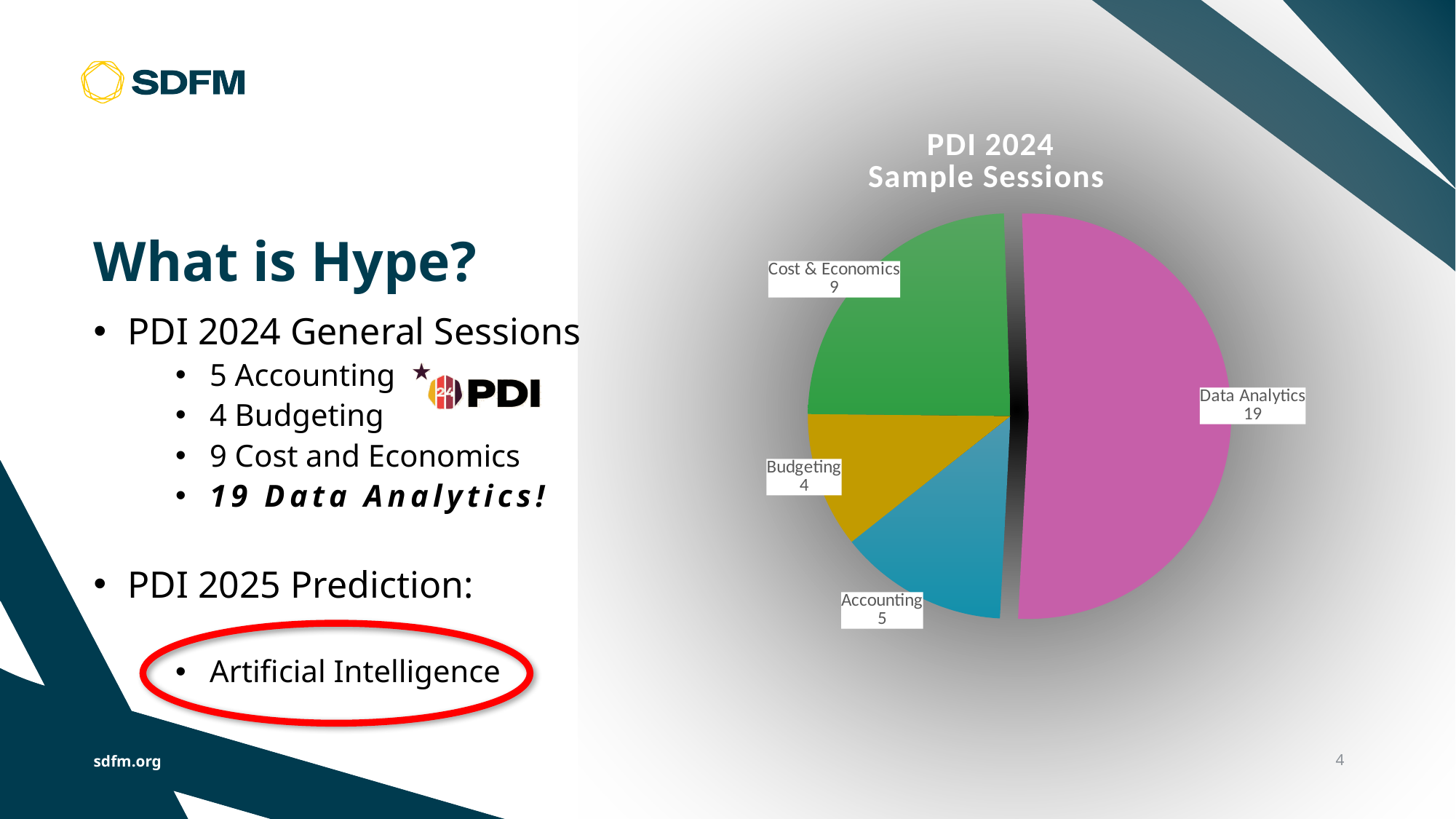
What is the value for Data Analytics? 19 What type of chart is shown on the slide? pie chart Which category has the largest slice? Data Analytics What is the value for Budgeting? 4 Which category has the smallest slice? Budgeting What is the difference between the values for Data Analytics and Cost & Economics? 10 What is the value for Cost & Economics? 9 What is the title of the chart? PDI 2024 Sample Sessions What is the value for Accounting? 5 How many slices does the pie chart have? 4 What is the total of all slices in the pie chart? 37 Which is larger, Accounting or Budgeting? Accounting